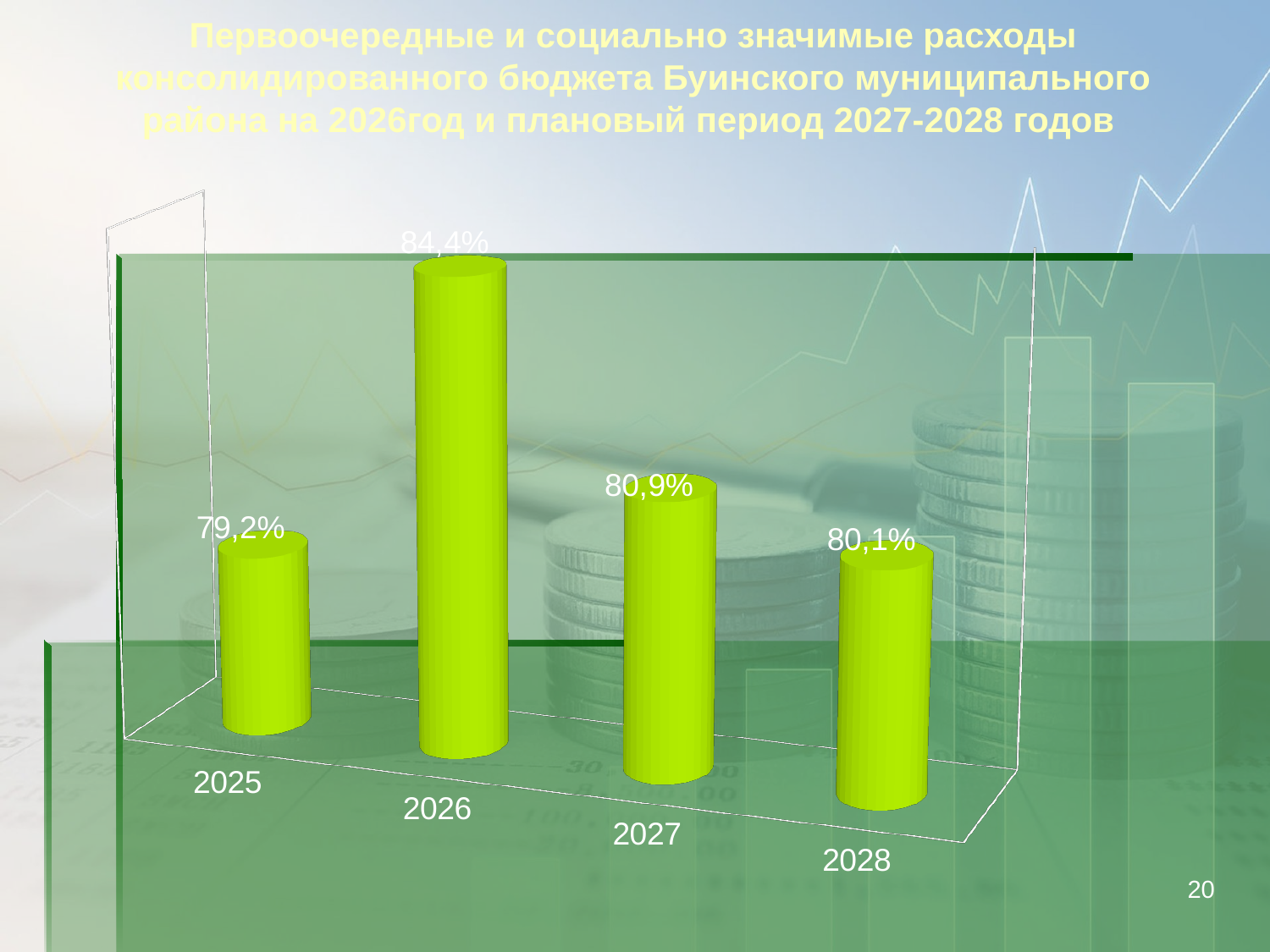
How many years are shown on the chart? 4 What kind of chart is shown on the slide? Bar chart What is the value shown for 2027? 80,9% What is the value shown for 2028? 80,1% Which year has the lowest value? 2025 What is the difference between the values for 2027 and 2028? 0,8% Which year has the highest value? 2026 What is the value shown for 2026? 84,4% What is the value shown for 2025? 79,2% Which is larger, the value for 2027 or the value for 2028? 2027 Does the value rise or fall from 2026 to 2028? Fall What is the difference between the values for 2026 and 2025? 5,2%